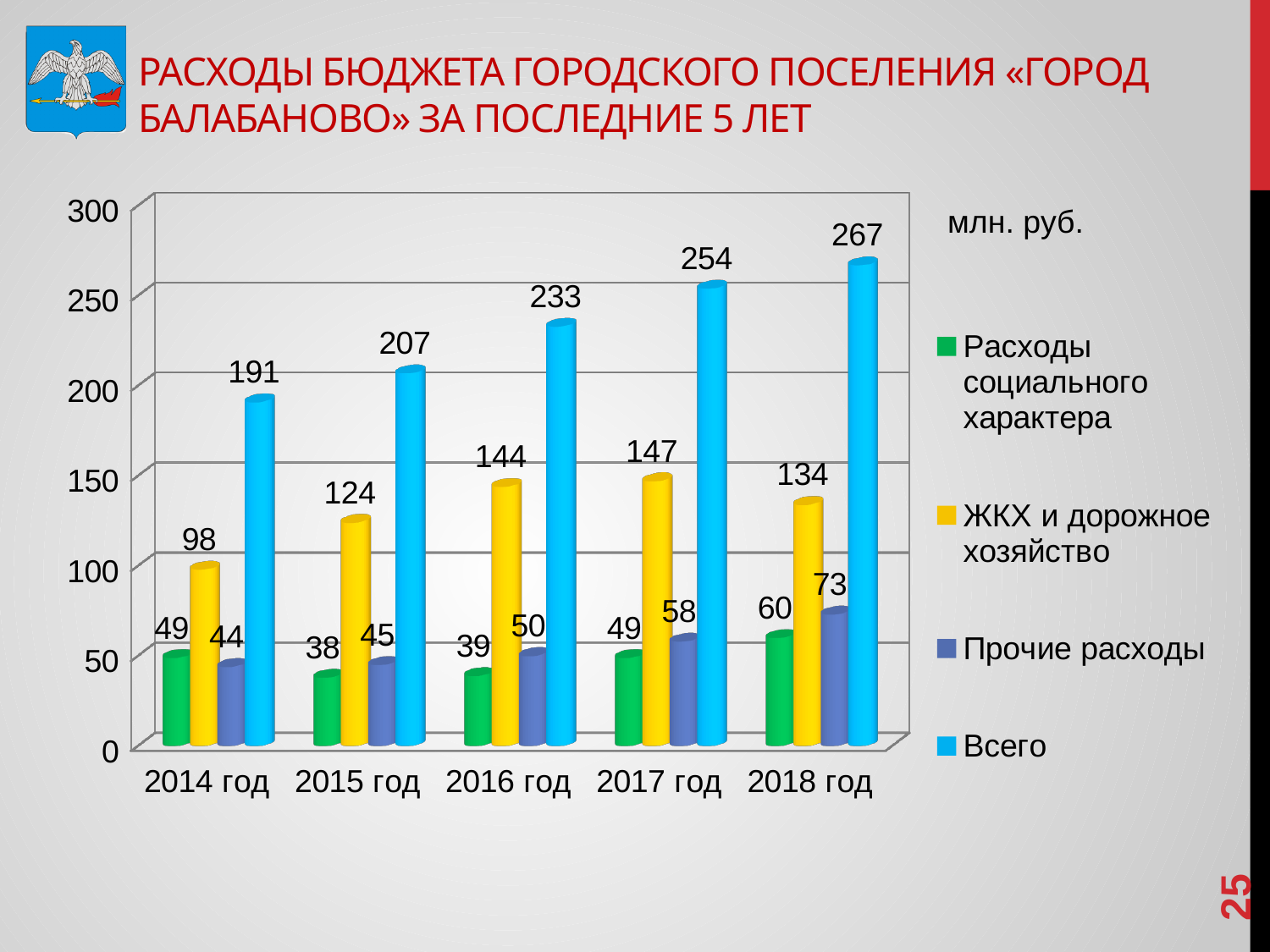
How many series does the legend list? 4 In which year is «Расходы социального характера» the lowest? 2015 год What is the value of «Расходы социального характера» for 2015 год? 38 Does «Всего» rise or fall from 2014 год to 2018 год? Rises What is the value of «Прочие расходы» for 2014 год? 44 In which year is «Всего» the highest? 2018 год What is the value of «Всего» for 2018 год? 267 What kind of chart is shown on the slide? Bar chart What is the difference between «Всего» in 2018 год and 2014 год? 76 Which is larger: «ЖКХ и дорожное хозяйство» in 2017 год or in 2018 год? 2017 год What is the value of «ЖКХ и дорожное хозяйство» for 2016 год? 144 How many years are shown on the x axis? 5